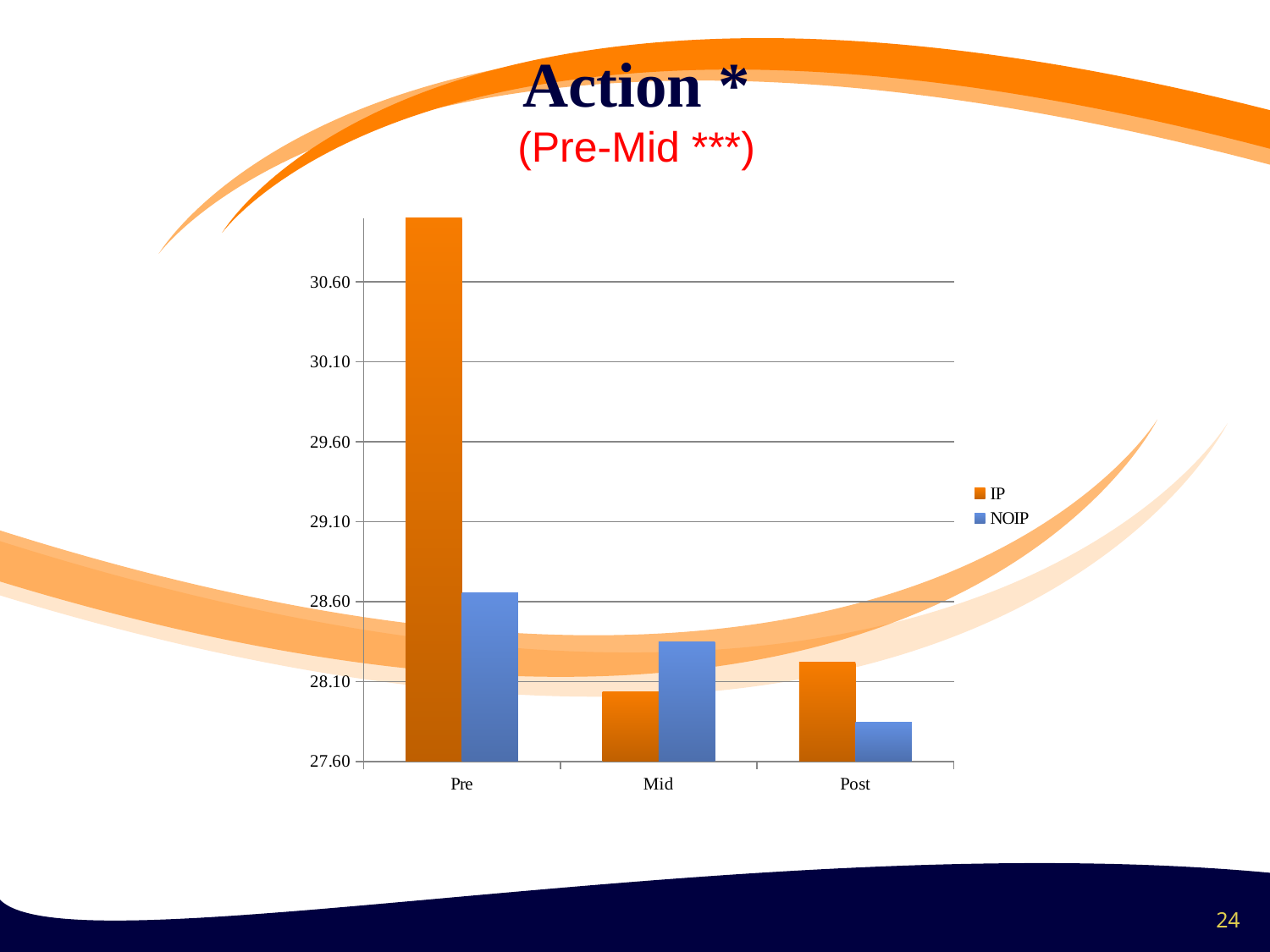
Which category has the lowest value for the NOIP series? Post Do the NOIP values rise or fall from Pre to Post? fall At Mid, which series has the larger value, IP or NOIP? NOIP How many categories are shown on the x axis? 3 Is the IP value for Pre greater or less than 30.60? greater Is the NOIP value for Mid greater or less than 28.10? greater Which category has the lowest value for the IP series? Mid Which category has the highest value for the IP series? Pre What kind of chart is shown on the slide? bar chart How many series does the legend list? 2 At Pre, which series has the larger value, IP or NOIP? IP Is the NOIP value for Post greater or less than 28.10? less